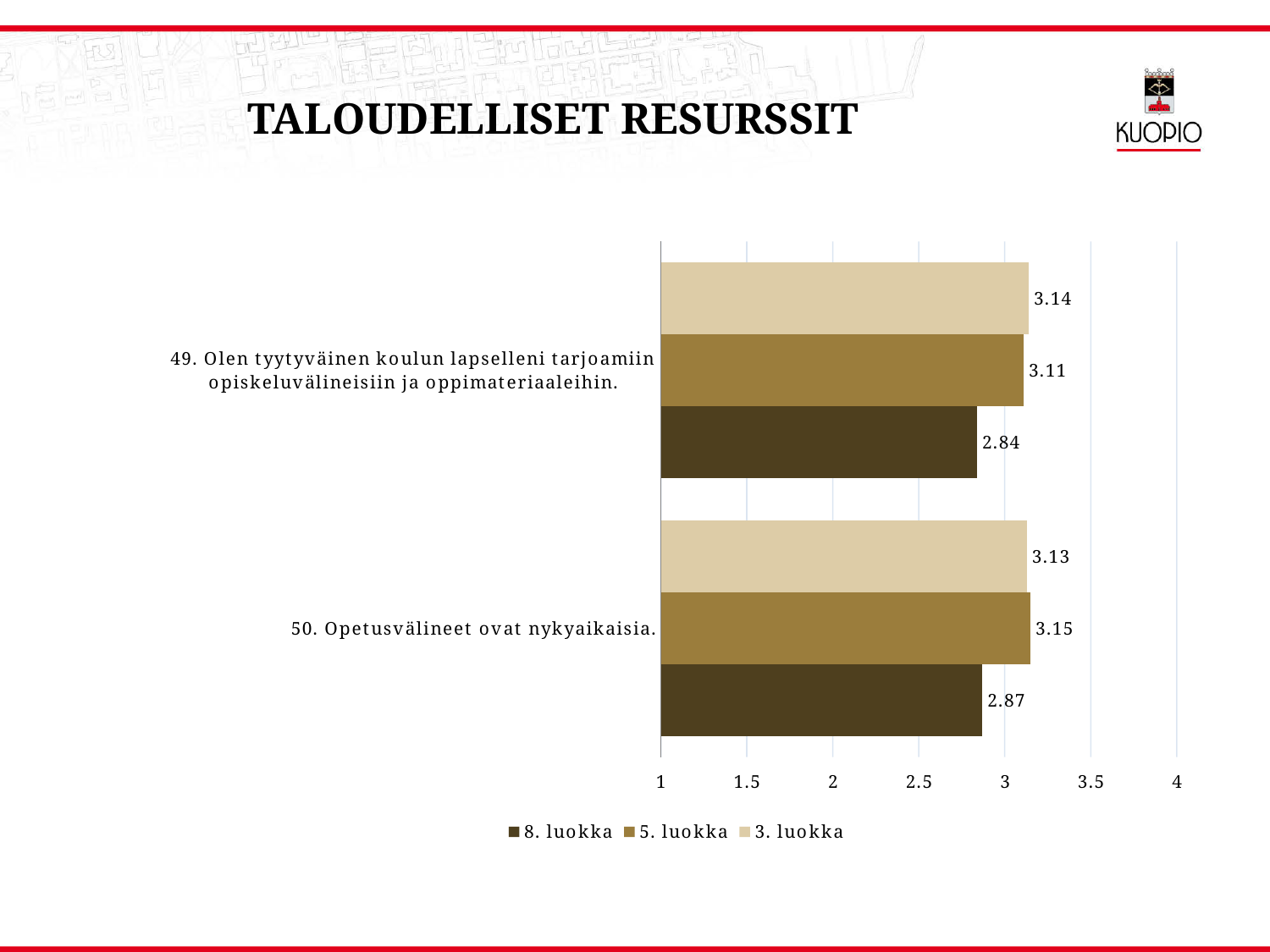
What is the value for 8. luokka on item 50 (Opetusvälineet ovat nykyaikaisia)? 2.87 How many series does the legend list? 3 Is the value for 8. luokka on item 49 greater or less than 3? less What is the difference between the 5. luokka and 8. luokka values on item 50? 0.28 What is the value for 3. luokka on item 49? 3.14 What is the value for 5. luokka on item 50 (Opetusvälineet ovat nykyaikaisia)? 3.15 Which series has the lowest value on item 50 (Opetusvälineet ovat nykyaikaisia)? 8. luokka How many question items (categories) are shown on the chart? 2 What is the value for 8. luokka on item 49 (Olen tyytyväinen koulun lapselleni tarjoamiin opiskeluvälineisiin ja oppimateriaaleihin)? 2.84 Which series has the highest value on item 49? 3. luokka What is the difference between the 3. luokka and 8. luokka values on item 49? 0.30 What kind of chart is shown on the slide? Bar chart